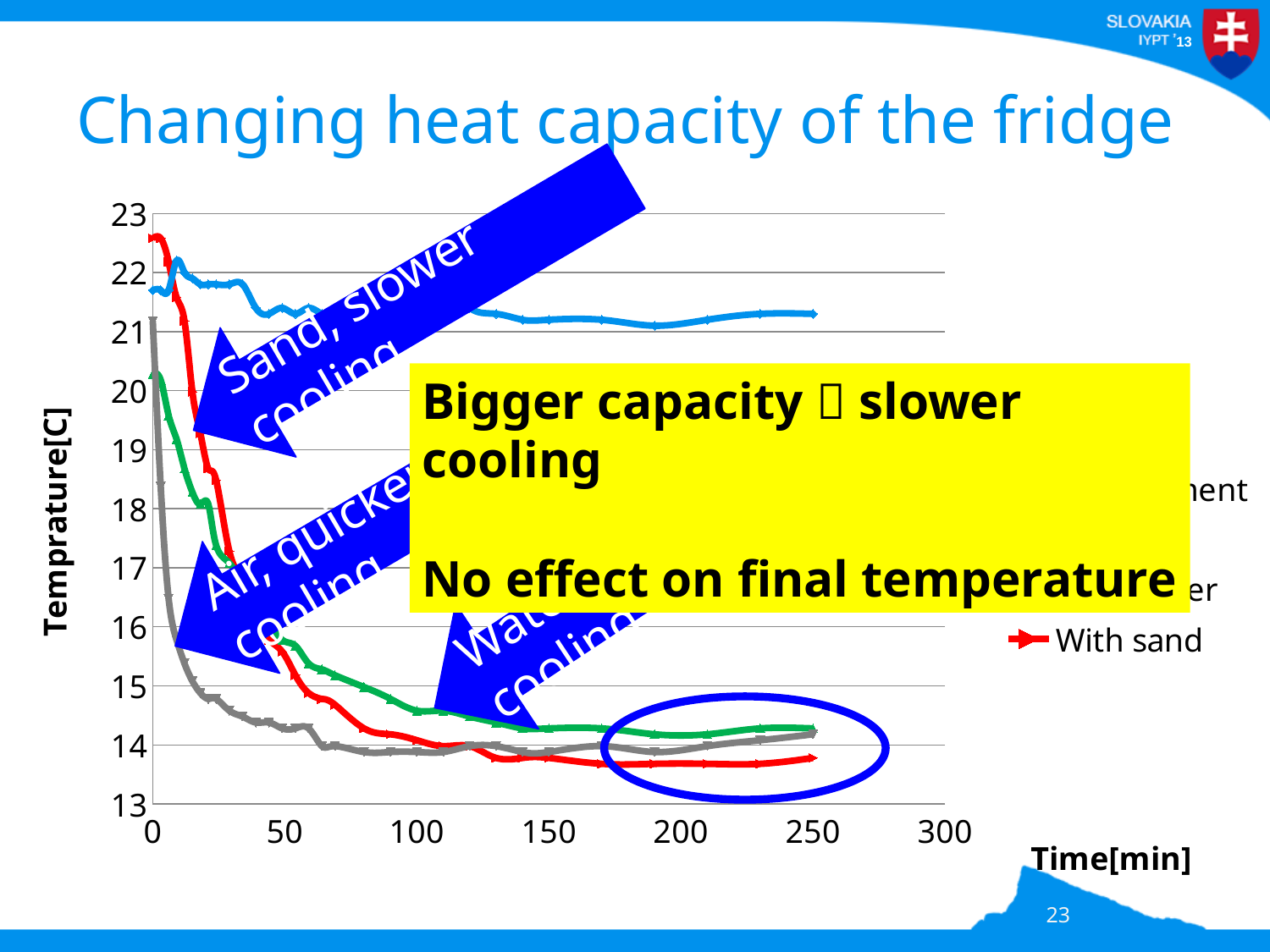
Is the value of the green line at 250 min greater or less than 15? less Which line has the highest value at 250 min? the blue line Does the red 'With sand' line rise or fall as time increases? fall Is the value of the blue line at 250 min greater or less than 20? greater Is the starting value of the red 'With sand' line at 0 min greater or less than 22? greater What is the largest value shown on the x axis? 300 What is the label of the x axis of the chart? Time[min] How many lines are plotted on the chart? 4 At 250 min, which line has the higher value, the blue line or the red 'With sand' line? the blue line What kind of chart is shown on the slide? line chart What is the title of the slide containing the chart? Changing heat capacity of the fridge